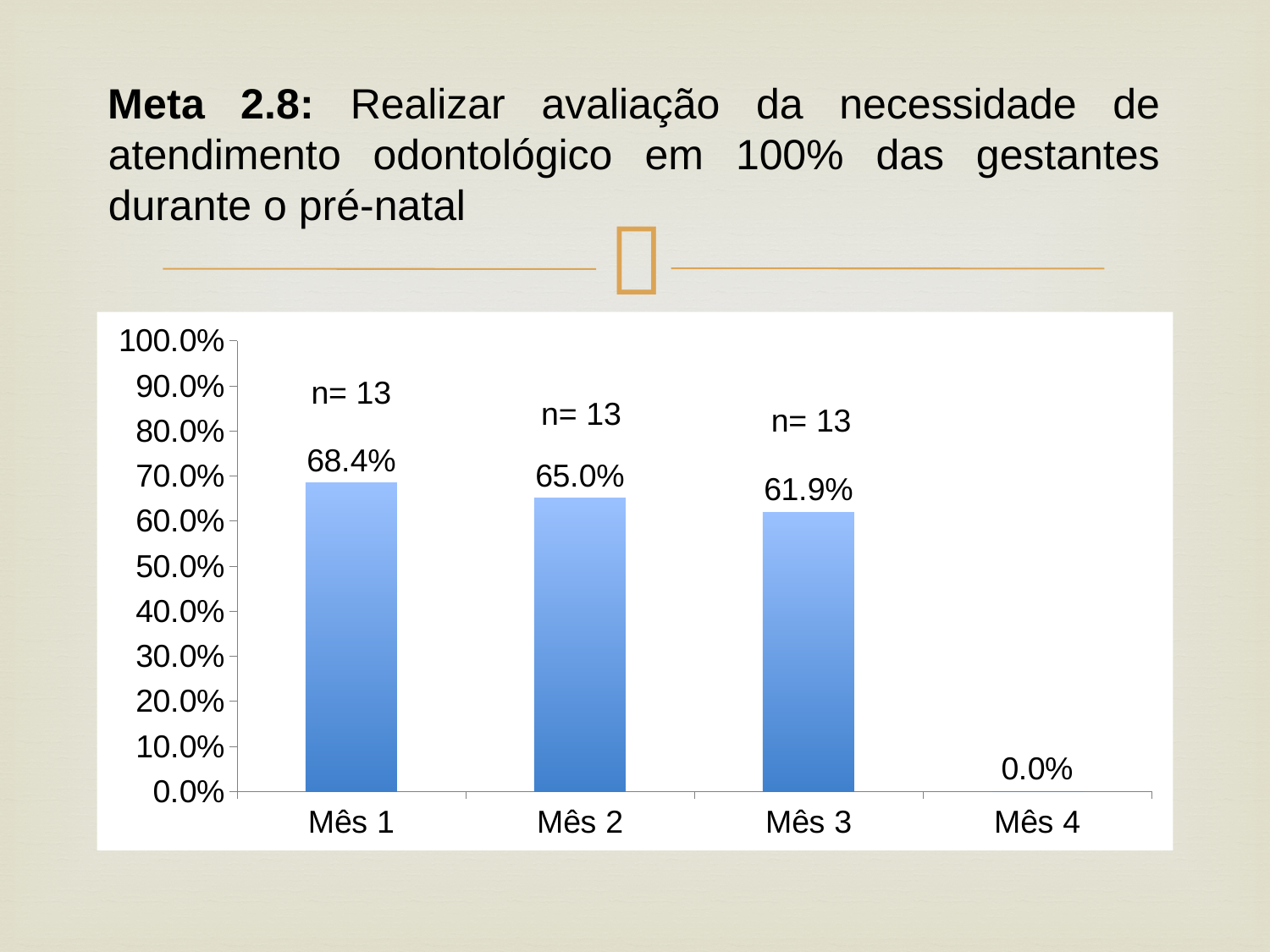
How many months are shown on the x axis? 4 Do the values rise or fall from Mês 1 to Mês 4? fall What kind of chart is shown on the slide? bar chart What is the difference between the values for Mês 1 and Mês 3? 6.5% What is the value for Mês 1? 68.4% What is the value for Mês 3? 61.9% Which month has the highest value? Mês 1 What is the value for Mês 4? 0.0% Is the value for Mês 1 greater or less than 60.0%? greater What is the value for Mês 2? 65.0% Which month has the lowest value? Mês 4 Which is larger, the value for Mês 2 or the value for Mês 3? Mês 2